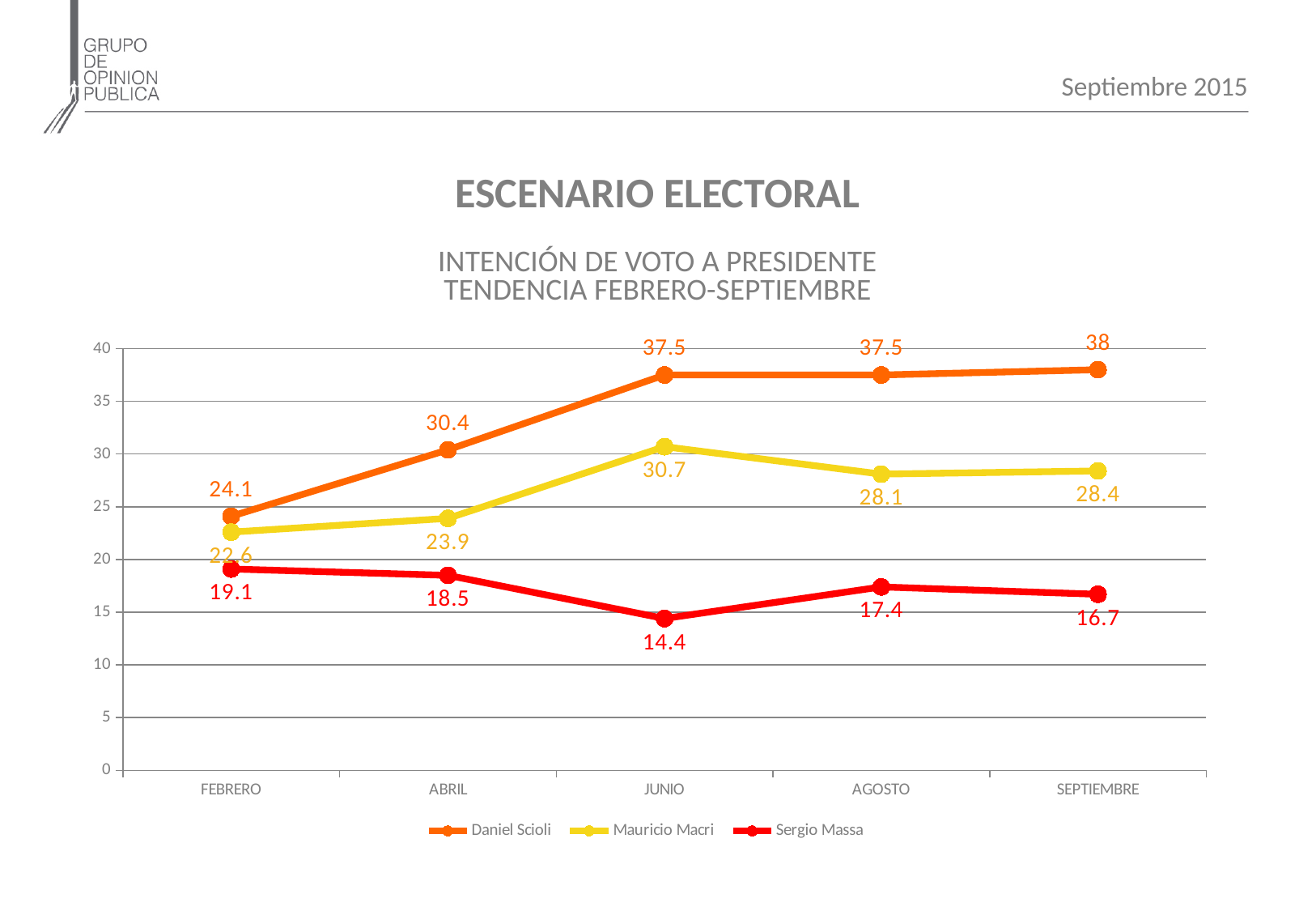
Which is larger in ABRIL, the value for Daniel Scioli or the value for Mauricio Macri? Daniel Scioli What is the value for Daniel Scioli in JUNIO? 37.5 What colour is the line for Sergio Massa? Red How many months are shown on the x axis? 5 How many series does the legend list? 3 What is the value for Mauricio Macri in AGOSTO? 28.1 What kind of chart is shown on the slide? Line chart In which month is Mauricio Macri's value highest? JUNIO What is the difference between Daniel Scioli's and Mauricio Macri's values in SEPTIEMBRE? 9.6 Does Daniel Scioli's line rise or fall from FEBRERO to SEPTIEMBRE? Rise What is the value for Sergio Massa in FEBRERO? 19.1 In which month is Sergio Massa's value lowest? JUNIO